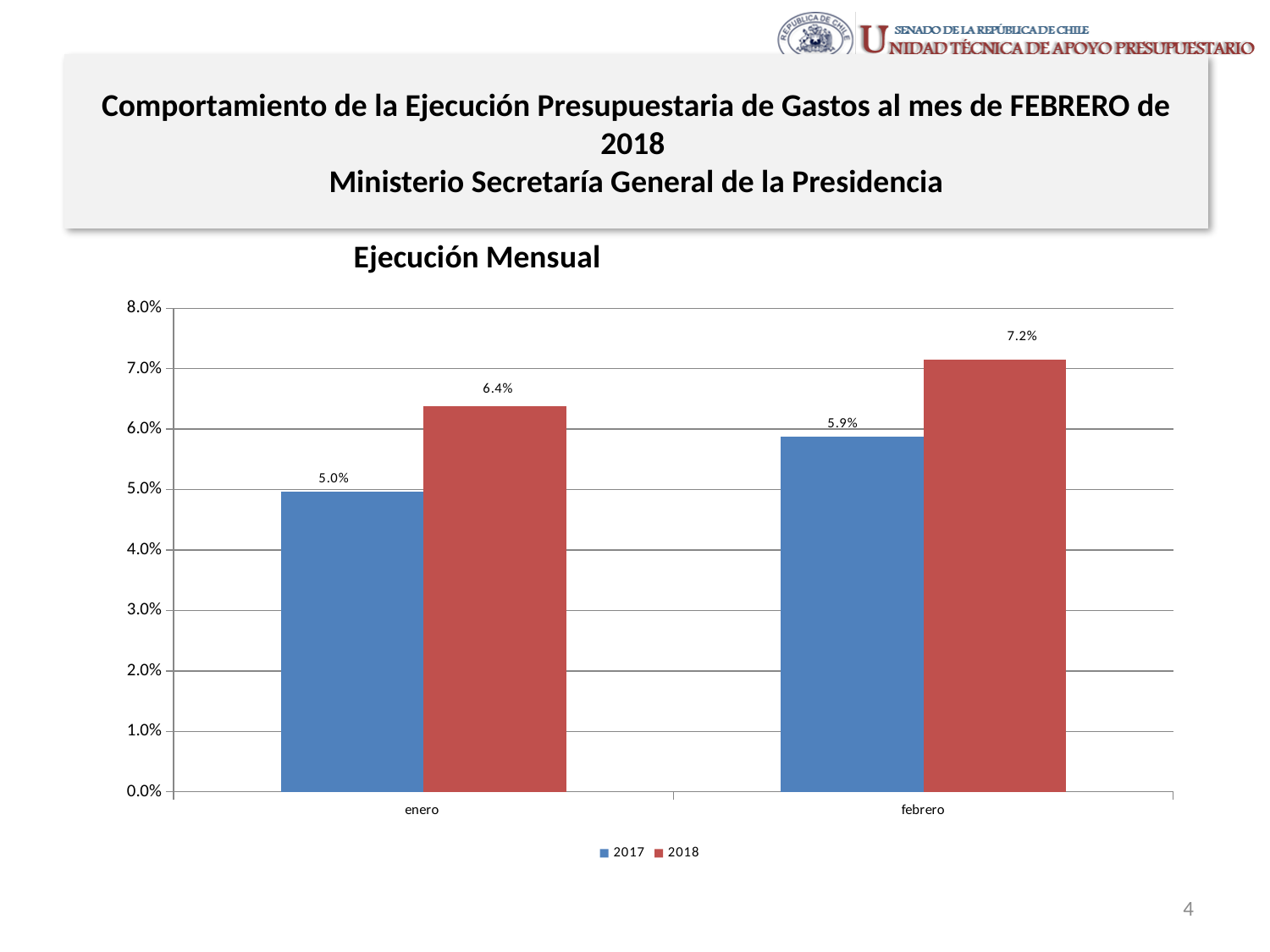
What kind of chart is shown? bar chart Which month has the lowest value for the 2017 series? enero Which month has the highest value for the 2018 series? febrero How many series does the legend list? 2 How many months are shown on the x axis? 2 Which is larger in enero: the 2017 value or the 2018 value? 2018 What is the difference between the 2018 and 2017 values in febrero? 1.3% What is the value for 2017 in enero? 5.0% What is the value for 2018 in febrero? 7.2% What is the value for 2018 in enero? 6.4% What is the title of the chart? Ejecución Mensual Is the value for 2017 in febrero greater or less than 6.0%? less